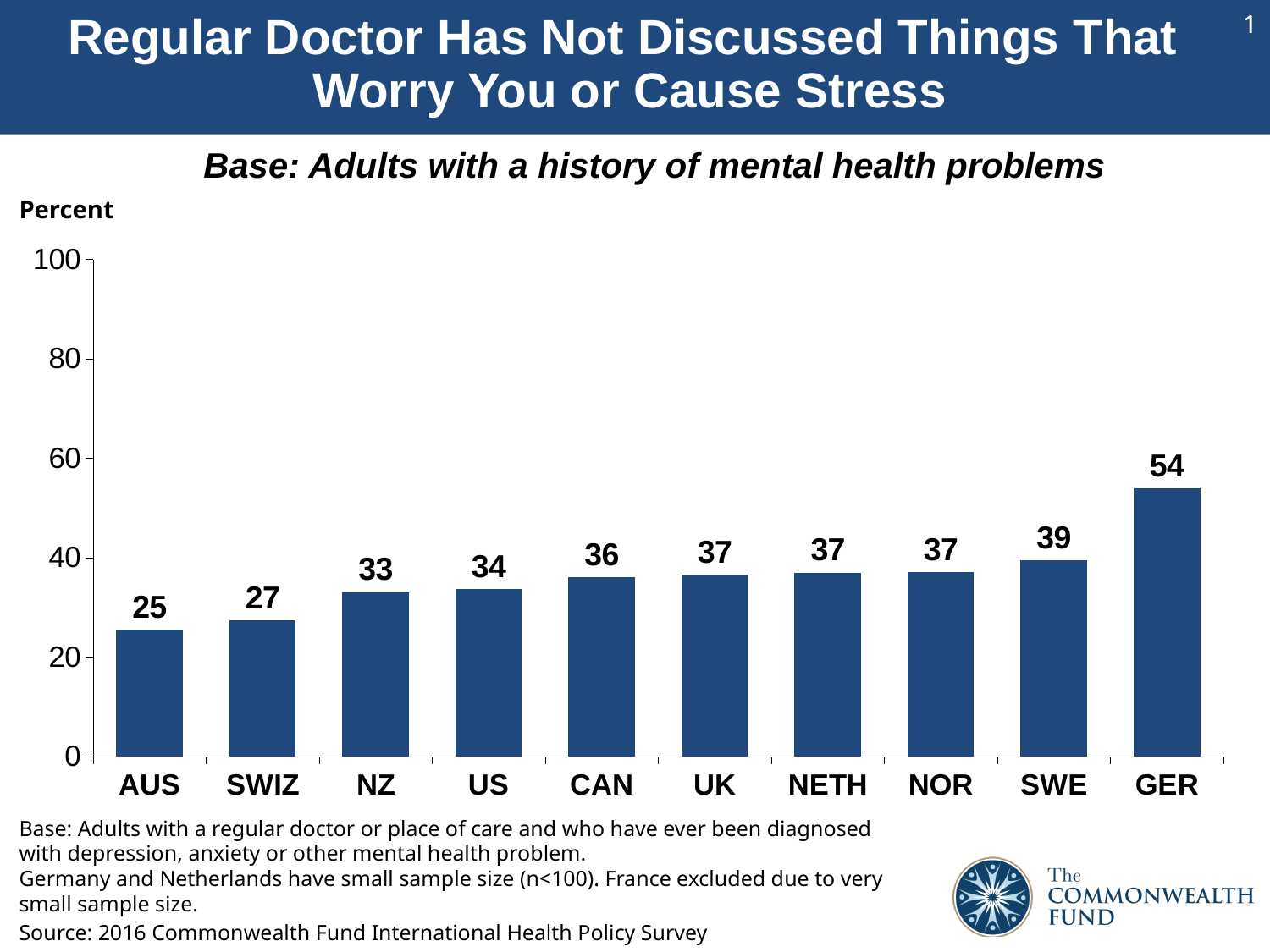
How many countries are shown on the chart? 10 What is the difference between the values for SWE and NZ? 6 Which country has the highest value? GER What is the difference between the values for GER and AUS? 29 What kind of chart is shown on the slide? bar chart Which country has the lowest value? AUS Which is larger, the value for US or the value for SWE? SWE What is the value for AUS? 25 What is the value for GER? 54 Is the value for GER greater or less than 60? less What is the label on the vertical axis of the chart? Percent What is the value for CAN? 36